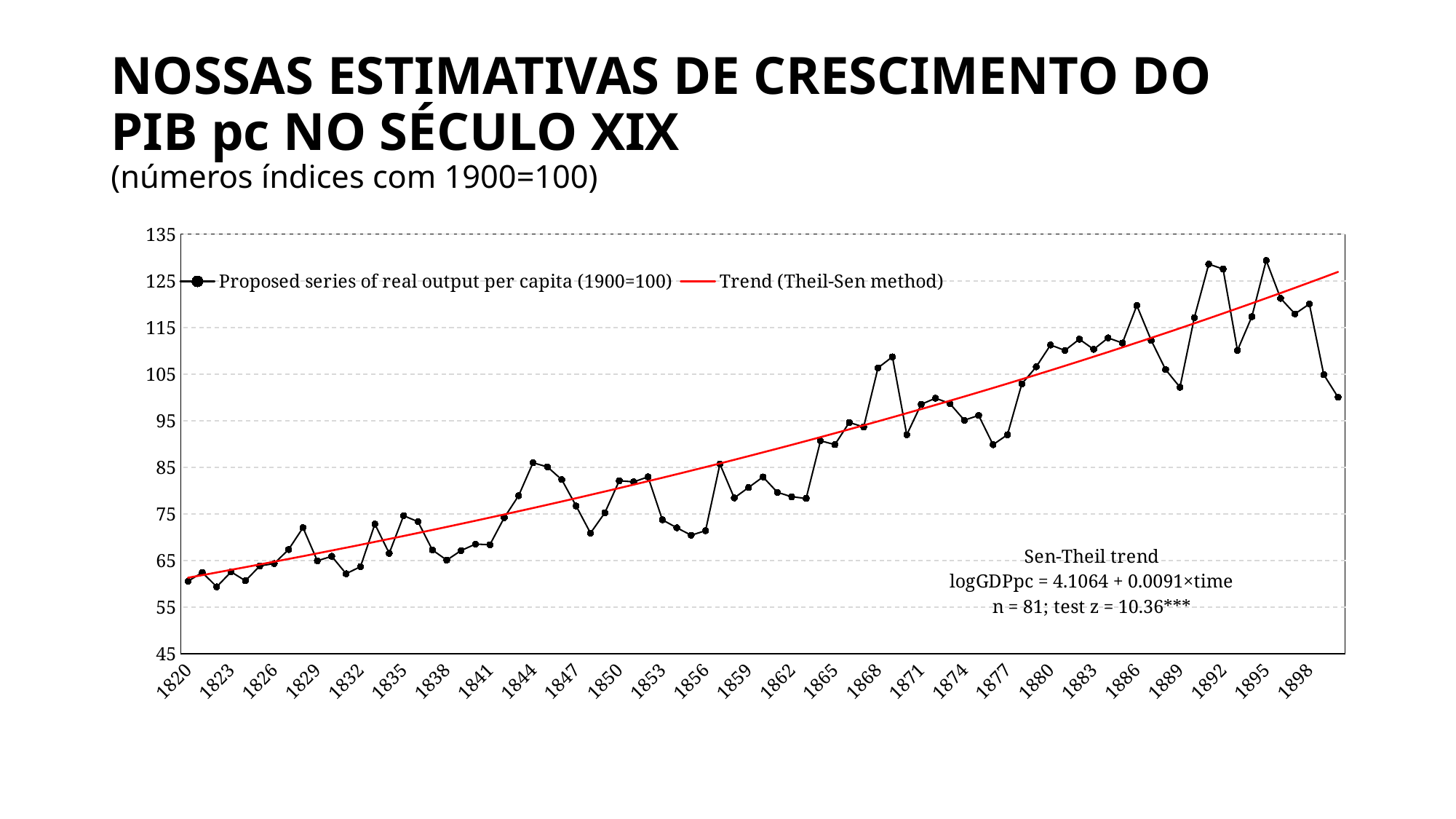
According to the annotation on the chart, what is the value of n for the Sen-Theil trend? 81 Which year has the larger value in the proposed series, 1844 or 1856? 1844 Is the value of the proposed series for 1868 greater or less than 95? greater Is the value of the proposed series for 1892 greater or less than 125? greater Is the value of the proposed series for 1877 greater or less than 95? less How many series does the legend list? 2 What colour is the Trend (Theil-Sen method) line? Red What kind of chart is shown on the slide? Line chart Which year has the larger value in the proposed series, 1820 or 1892? 1892 Overall, do the values of the proposed series of real output per capita rise or fall from 1820 to the end of the period? Rise